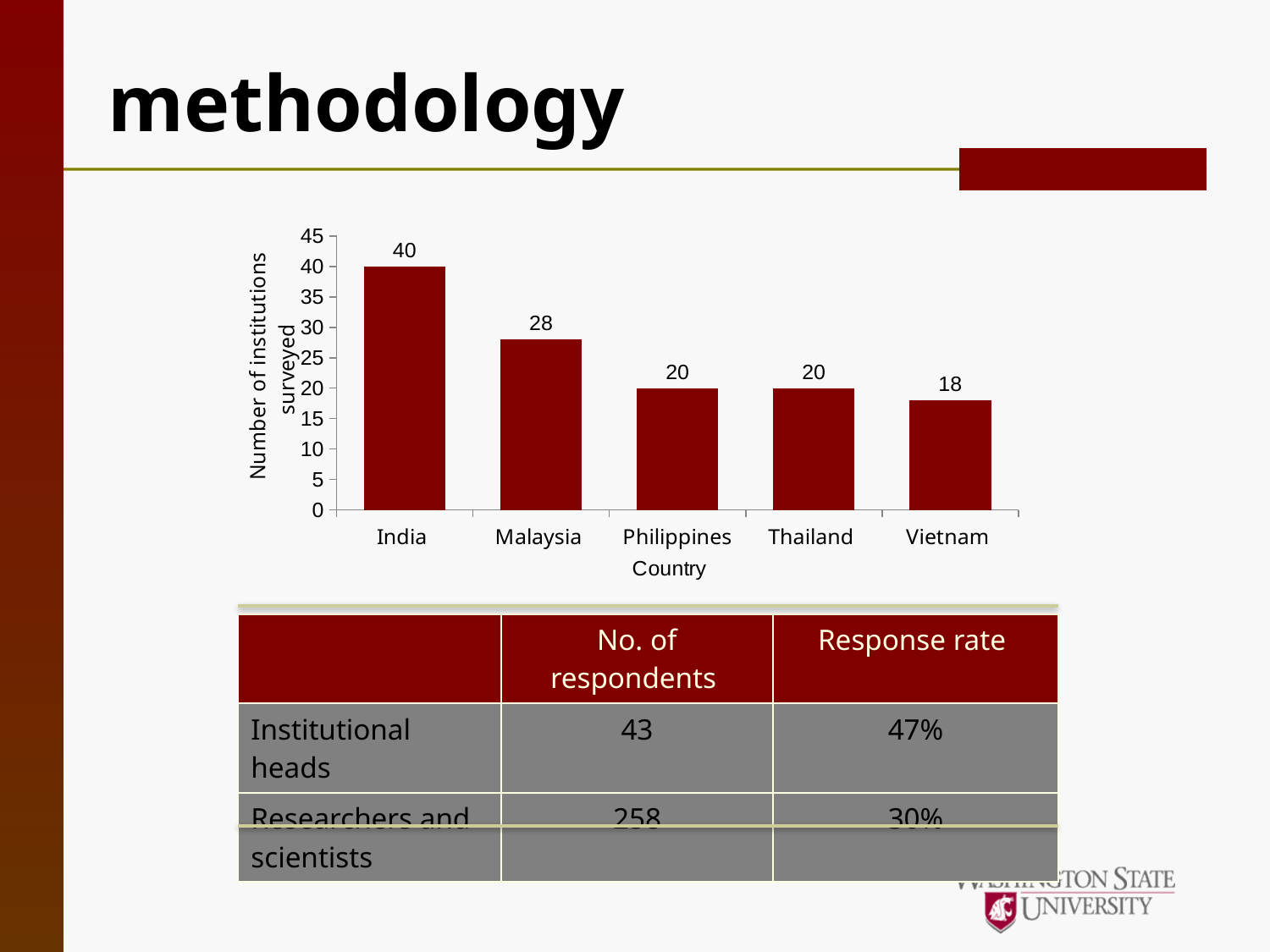
What is the label of the horizontal axis of the chart? Country Which country has the lowest number of institutions surveyed? Vietnam How many countries are shown on the x axis of the chart? 5 How many institutions were surveyed in Malaysia? 28 What is the label of the vertical axis of the chart? Number of institutions surveyed What is the difference between the number of institutions surveyed in Thailand and in Vietnam? 2 What is the difference between the number of institutions surveyed in India and in Malaysia? 12 Which country has the highest number of institutions surveyed? India How many institutions were surveyed in Vietnam? 18 What type of chart is shown on the slide? Bar chart How many institutions were surveyed in India? 40 Which has more institutions surveyed, Malaysia or the Philippines? Malaysia